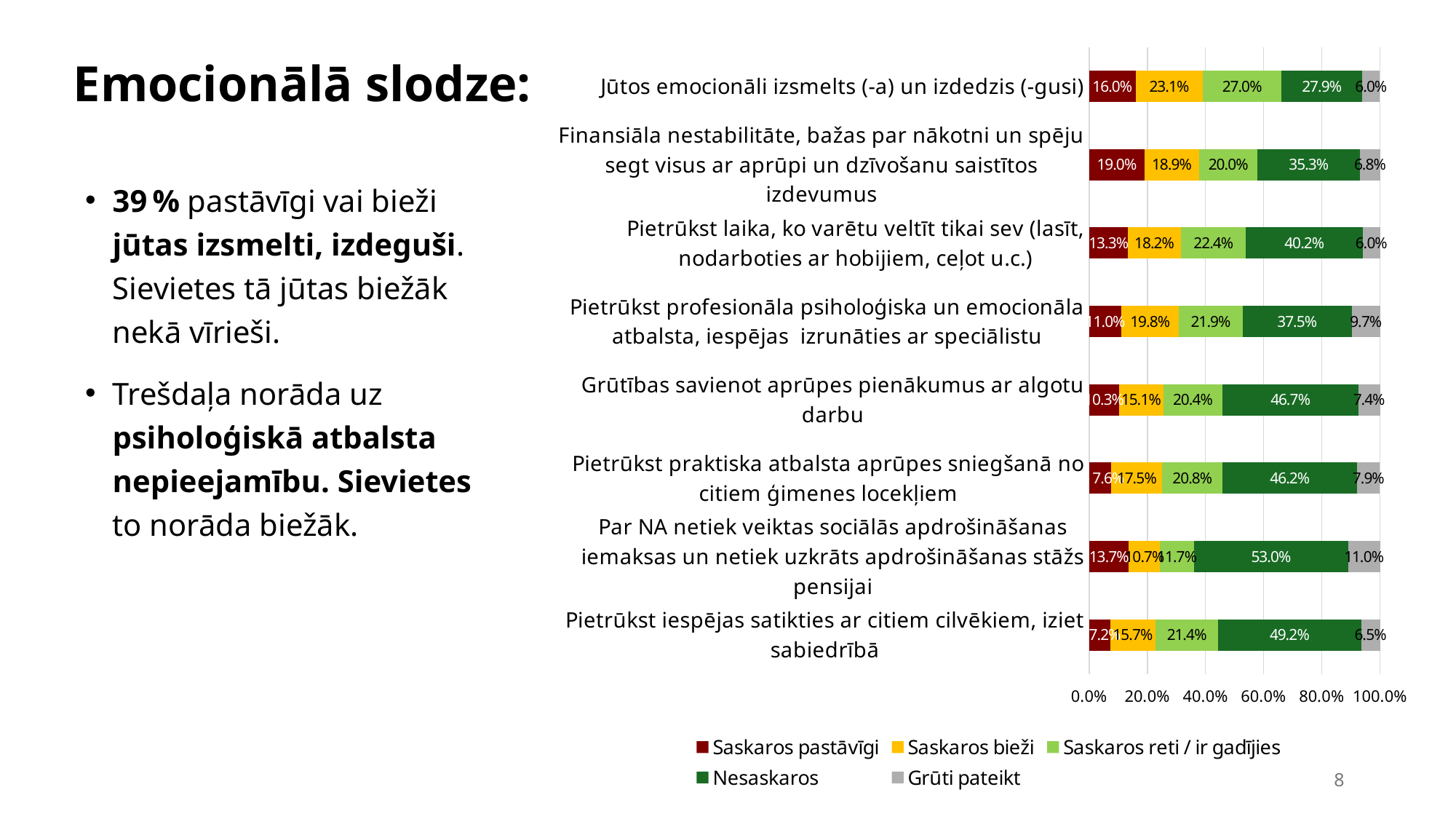
What is the 'Saskaros reti / ir gadījies' value for 'Pietrūkst praktiska atbalsta aprūpes sniegšanā no citiem ģimenes locekļiem'? 20.8% What is the 'Grūti pateikt' value for 'Pietrūkst profesionāla psiholoģiska un emocionāla atbalsta, iespējas izrunāties ar speciālistu'? 9.7% What is the 'Nesaskaros' value for 'Finansiāla nestabilitāte, bažas par nākotni un spēju segt visus ar aprūpi un dzīvošanu saistītos izdevumus'? 35.3% What is the 'Saskaros pastāvīgi' value for 'Jūtos emocionāli izsmelts (-a) un izdedzis (-gusi)'? 16.0% What kind of chart is shown on the slide? stacked bar chart How many categories (statements) does the chart show? 8 What colour represents the 'Nesaskaros' series in the chart? dark green How many series does the legend list? 5 Which category has the lowest 'Saskaros pastāvīgi' value among those with readable labels? Pietrūkst iespējas satikties ar citiem cilvēkiem, iziet sabiedrībā Which is larger: the 'Nesaskaros' value for 'Pietrūkst laika, ko varētu veltīt tikai sev' or for 'Pietrūkst iespējas satikties ar citiem cilvēkiem, iziet sabiedrībā'? Pietrūkst iespējas satikties ar citiem cilvēkiem, iziet sabiedrībā What is the difference between the 'Saskaros bieži' values for 'Jūtos emocionāli izsmelts (-a) un izdedzis (-gusi)' and 'Pietrūkst laika, ko varētu veltīt tikai sev'? 4.9% Which category has the highest 'Nesaskaros' value? Par NA netiek veiktas sociālās apdrošināšanas iemaksas un netiek uzkrāts apdrošināšanas stāžs pensijai